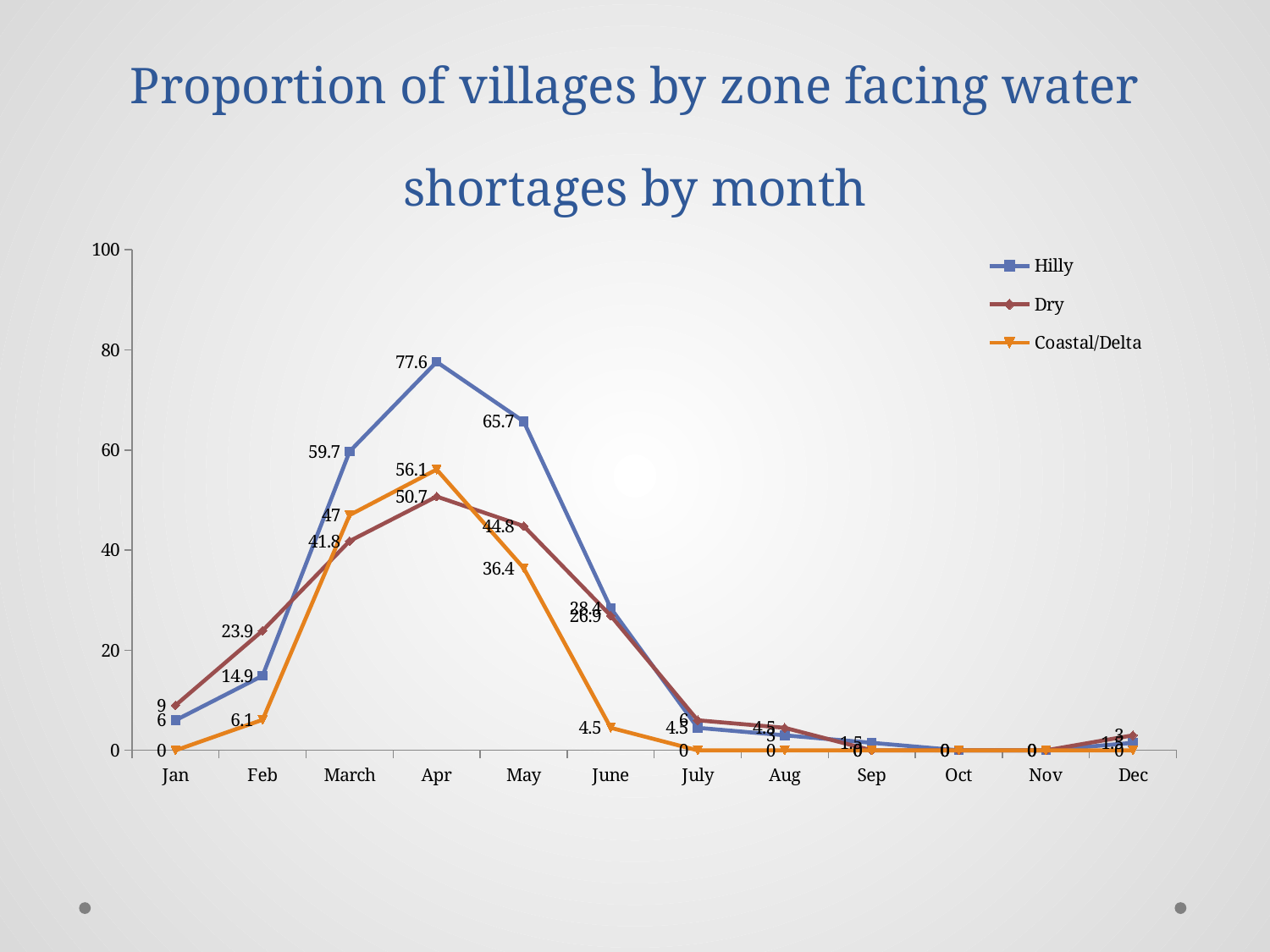
How many series does the legend list? 3 What is the value for Dry in Feb? 23.9 What is the value for Hilly in Apr? 77.6 How many months are shown on the x axis? 12 What is the difference between the Hilly and Dry values in Apr? 26.9 In March, which series has the larger value, Hilly or Coastal/Delta? Hilly What kind of chart is shown on the slide? Line chart Is the value for Hilly in May greater or less than 60? greater Do the Hilly values rise or fall from Apr to July? Fall What is the value for Dry in March? 41.8 In which month does the Hilly series reach its highest value? Apr What is the value for Coastal/Delta in May? 36.4